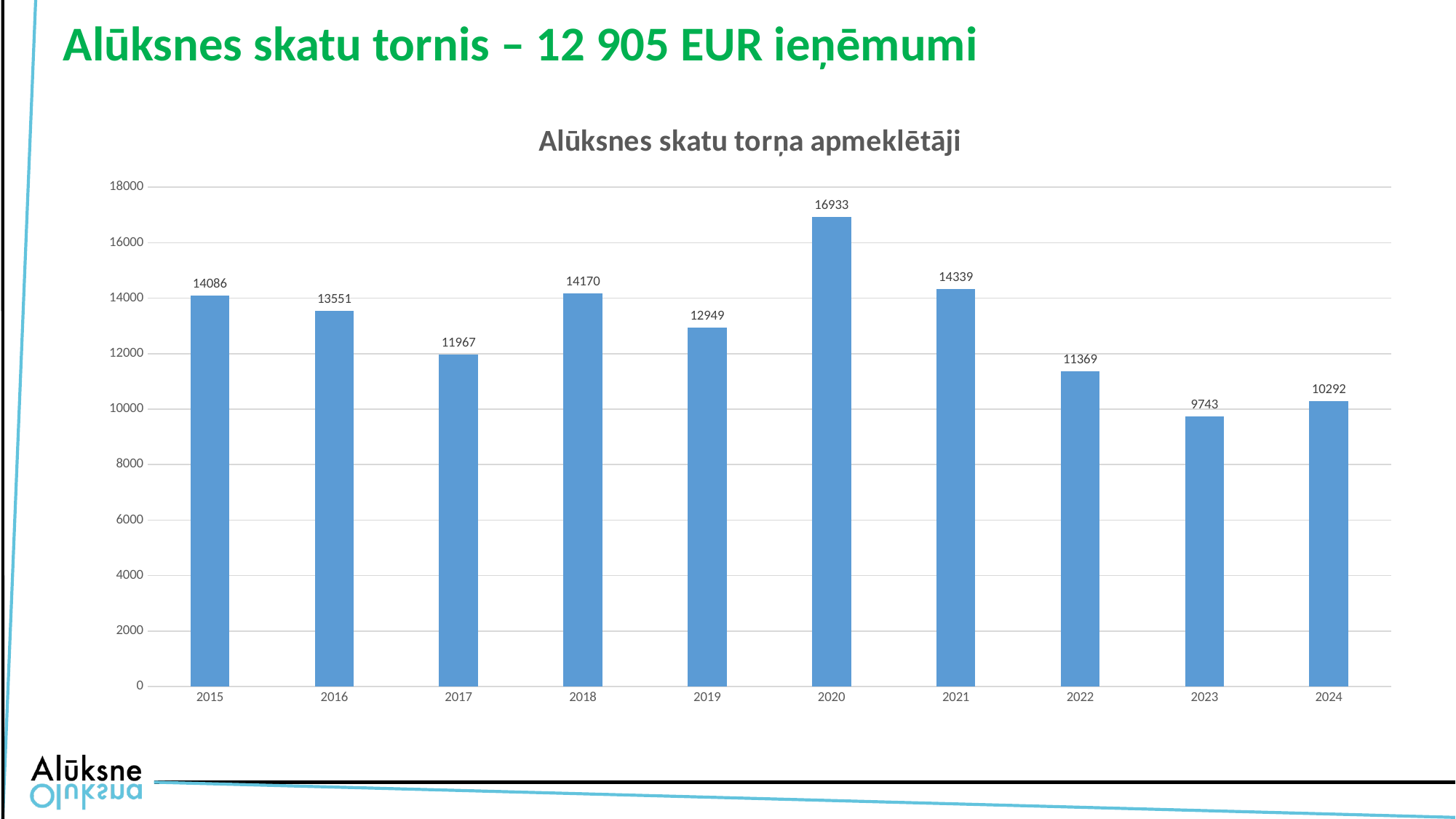
What is the difference between the values for 2020 and 2019? 3984 What kind of chart is shown? bar chart Which is larger, the value for 2016 or the value for 2022? 2016 What is the title of the chart? Alūksnes skatu torņa apmeklētāji What is the value for 2020? 16933 What is the value for 2023? 9743 Is the value for 2021 greater or less than 14000? greater Which year has the highest value? 2020 Which year has the lowest value? 2023 How many years are shown on the x axis? 10 What is the difference between the values for 2024 and 2023? 549 What is the value for 2017? 11967